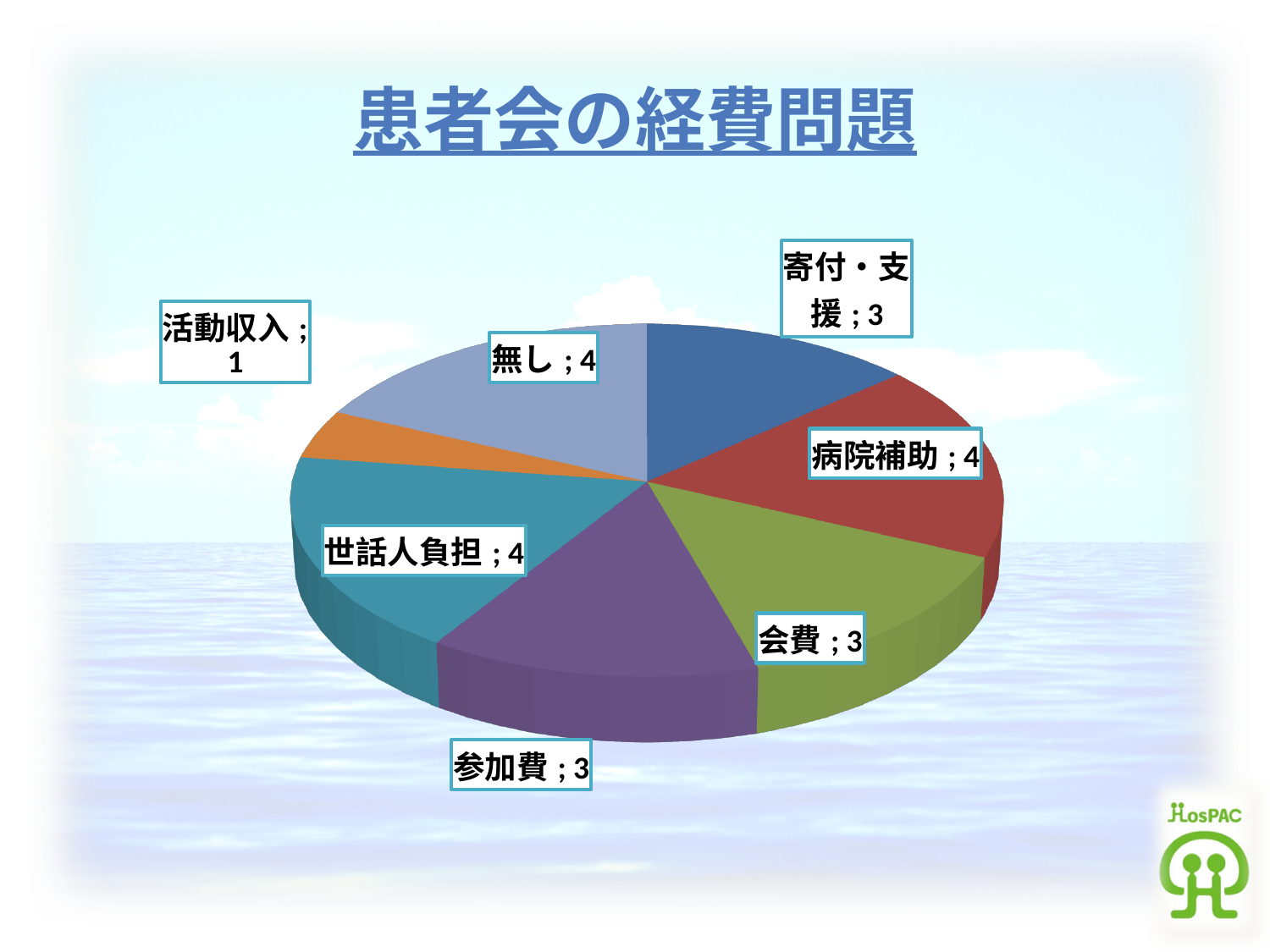
What is the value for 病院補助? 4 Which category has the smallest value? 活動収入 How many slices does the pie chart have? 7 Which is larger, the value for 会費 or the value for 活動収入? 会費 What is the value for 活動収入? 1 What is the difference between the values for 病院補助 and 活動収入? 3 What is the difference between the values for 無し and 参加費? 1 What kind of chart is shown on the slide? pie chart What is the total of all the slice values in the pie chart? 22 What is the title of the chart? 患者会の経費問題 What is the value for 世話人負担? 4 What is the value for 寄付・支援? 3